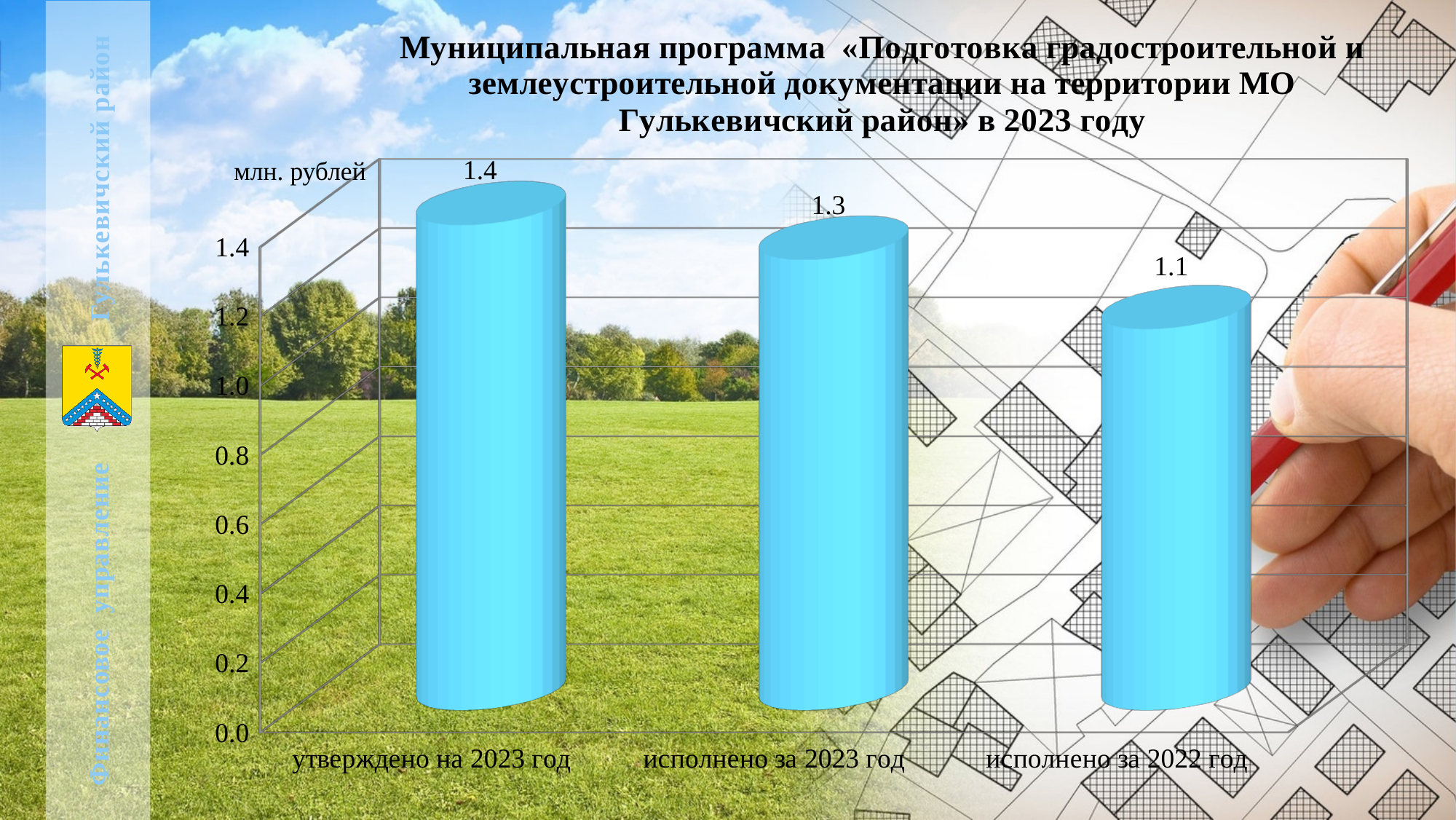
What kind of chart is shown on the slide? bar chart What is the difference between the value for «утверждено на 2023 год» and the value for «исполнено за 2023 год»? 0.1 What is the value for «исполнено за 2023 год»? 1.3 What is the value for «исполнено за 2022 год»? 1.1 Which category has the highest value? утверждено на 2023 год Is the value for «исполнено за 2022 год» greater or less than 1.2? less Which category has the lowest value? исполнено за 2022 год What is the difference between the value for «исполнено за 2023 год» and the value for «исполнено за 2022 год»? 0.2 Which is larger: the value for «исполнено за 2023 год» or the value for «исполнено за 2022 год»? исполнено за 2023 год How many categories are shown on the chart? 3 What is the value for «утверждено на 2023 год»? 1.4 What unit is indicated for the values on the chart? млн. рублей